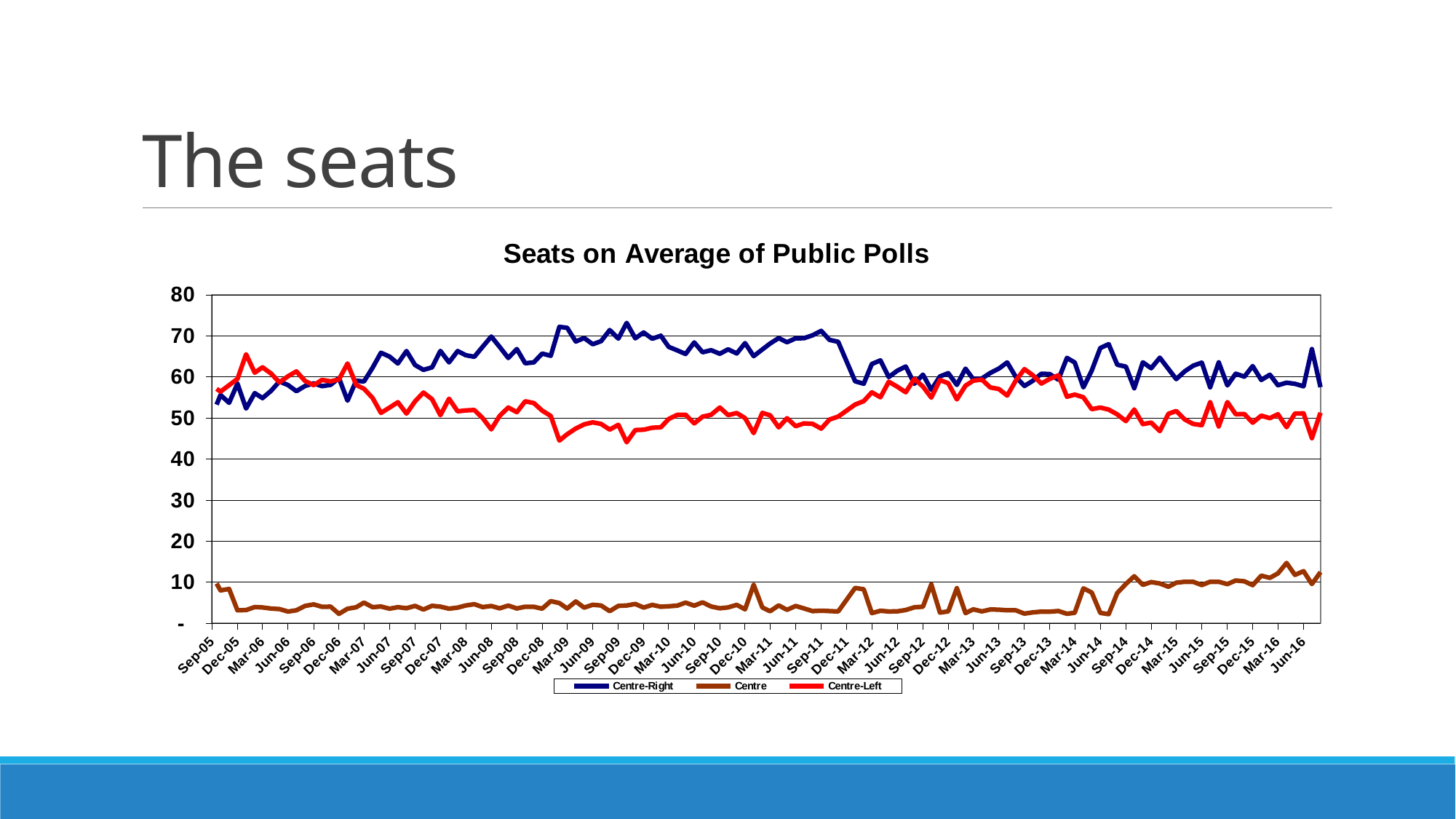
What kind of chart is shown on the slide? Line chart Which series has the lowest values across the whole period? Centre How many date labels are shown on the x axis? 44 What is the title of the chart? Seats on Average of Public Polls Is the value for Centre-Left at Mar-09 greater or less than 50? less At Sep-09, which is larger: Centre-Right or Centre-Left? Centre-Right Is the value for Centre at Dec-05 greater or less than 10? less Which series is drawn in red? Centre-Left Is the value for Centre-Right at Sep-09 greater or less than 60? greater How many series does the legend list? 3